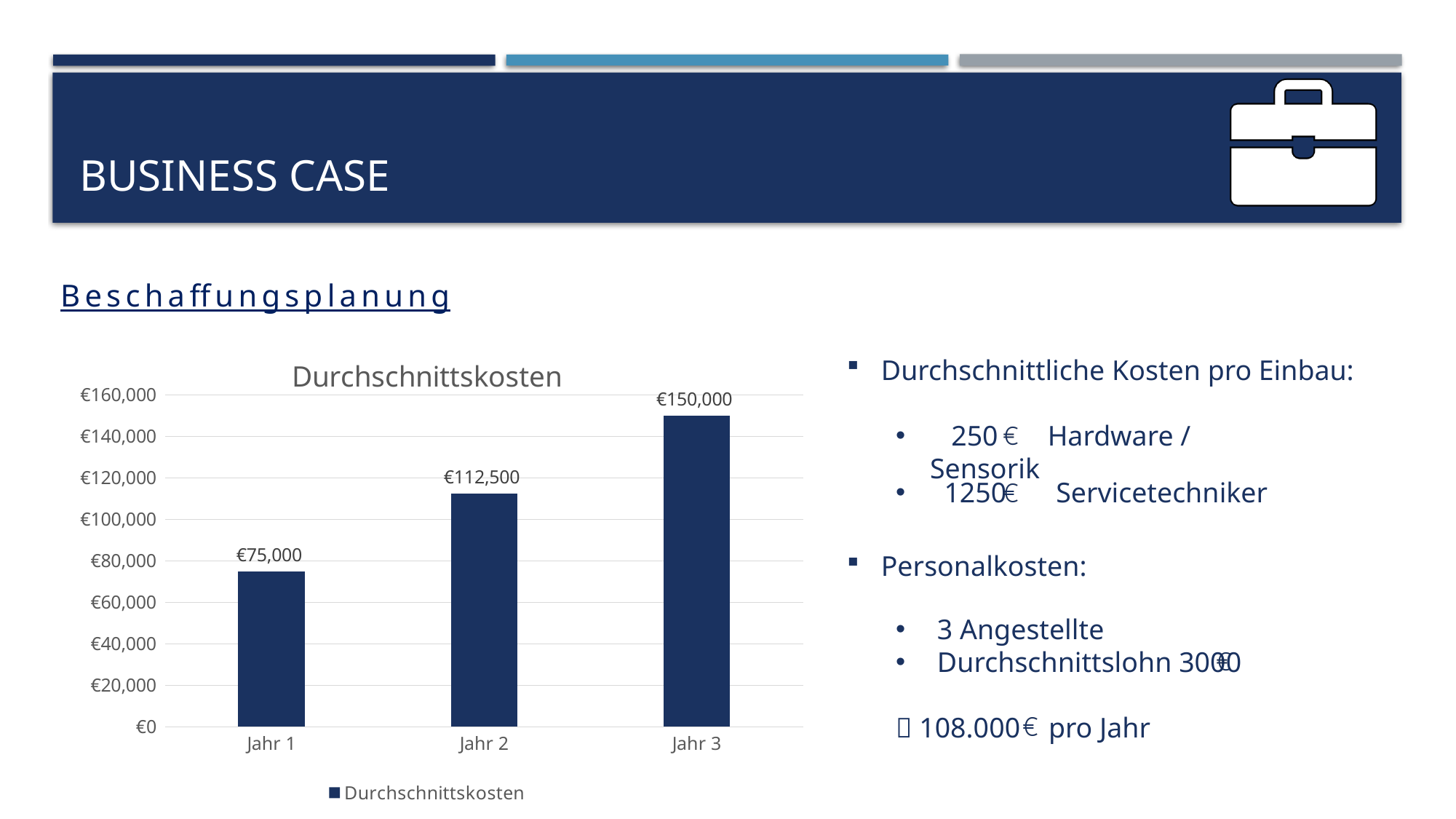
What is the value for Jahr 2 in the Durchschnittskosten chart? €112,500 Which year has the highest Durchschnittskosten? Jahr 3 What kind of chart is the Durchschnittskosten chart? bar chart What is the difference between the Durchschnittskosten for Jahr 2 and Jahr 1? €37,500 What is the value for Jahr 3 in the Durchschnittskosten chart? €150,000 Is the value for Jahr 2 greater or less than €100,000? greater Which is larger, the Durchschnittskosten for Jahr 2 or Jahr 3? Jahr 3 Which year has the lowest Durchschnittskosten? Jahr 1 What is the difference between the Durchschnittskosten for Jahr 3 and Jahr 1? €75,000 How many years are shown on the x axis of the Durchschnittskosten chart? 3 What is the value for Jahr 1 in the Durchschnittskosten chart? €75,000 Do the Durchschnittskosten values rise or fall from Jahr 1 to Jahr 3? rise